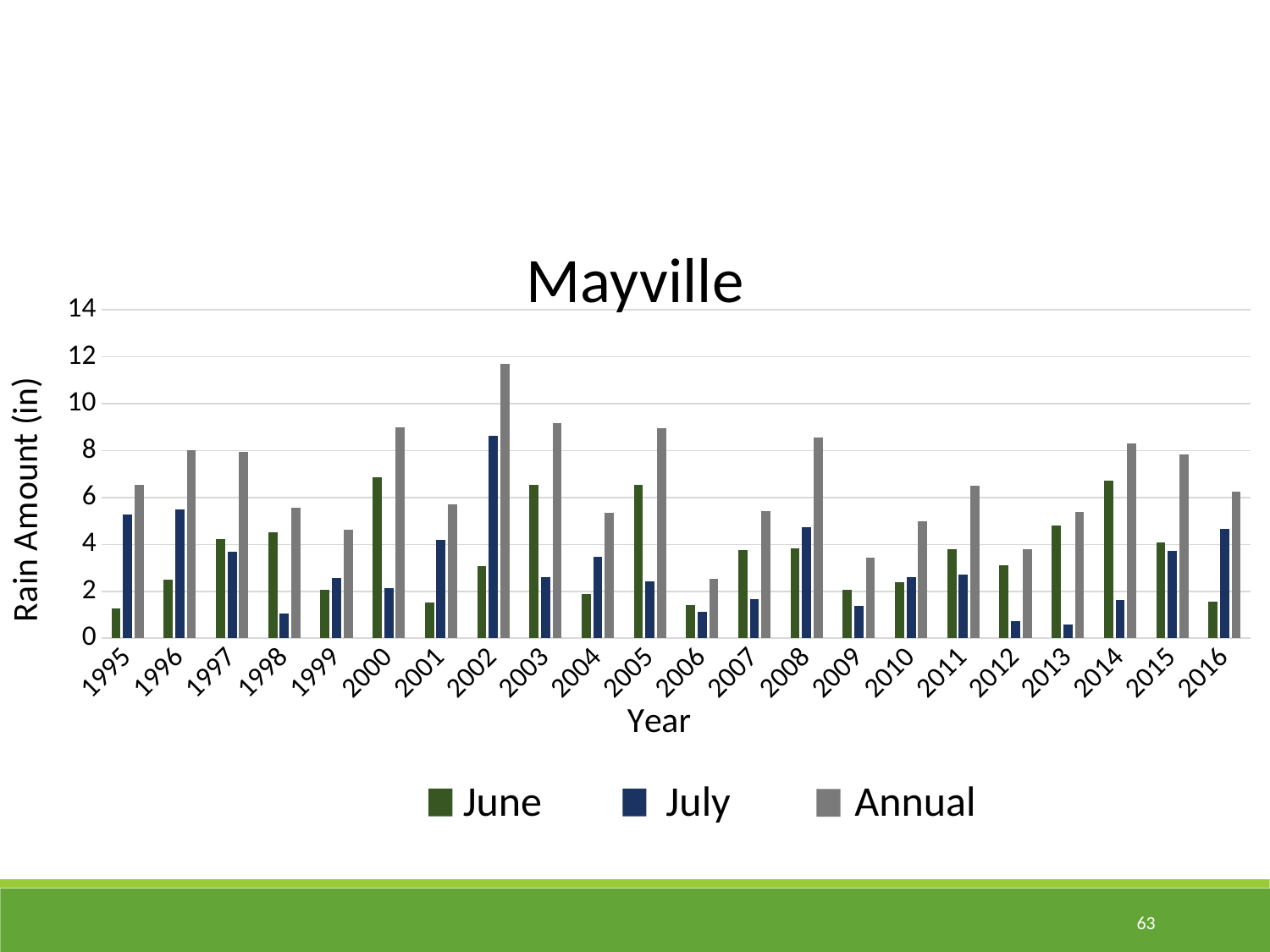
What is the title of the chart? Mayville Is the July value for 1998 greater or less than 2? less In 2014, which is larger, the June value or the July value? June Is the Annual value for 2002 greater or less than 10? greater What kind of chart is shown on the slide? bar chart How many years are shown on the x axis? 22 Is the Annual value for 2006 greater or less than 4? less Which year has the highest July rain amount? 2002 In 1995, which is larger, the June value or the July value? July How many series does the legend list? 3 Which year has the highest Annual rain amount? 2002 Which year has the lowest Annual rain amount? 2006